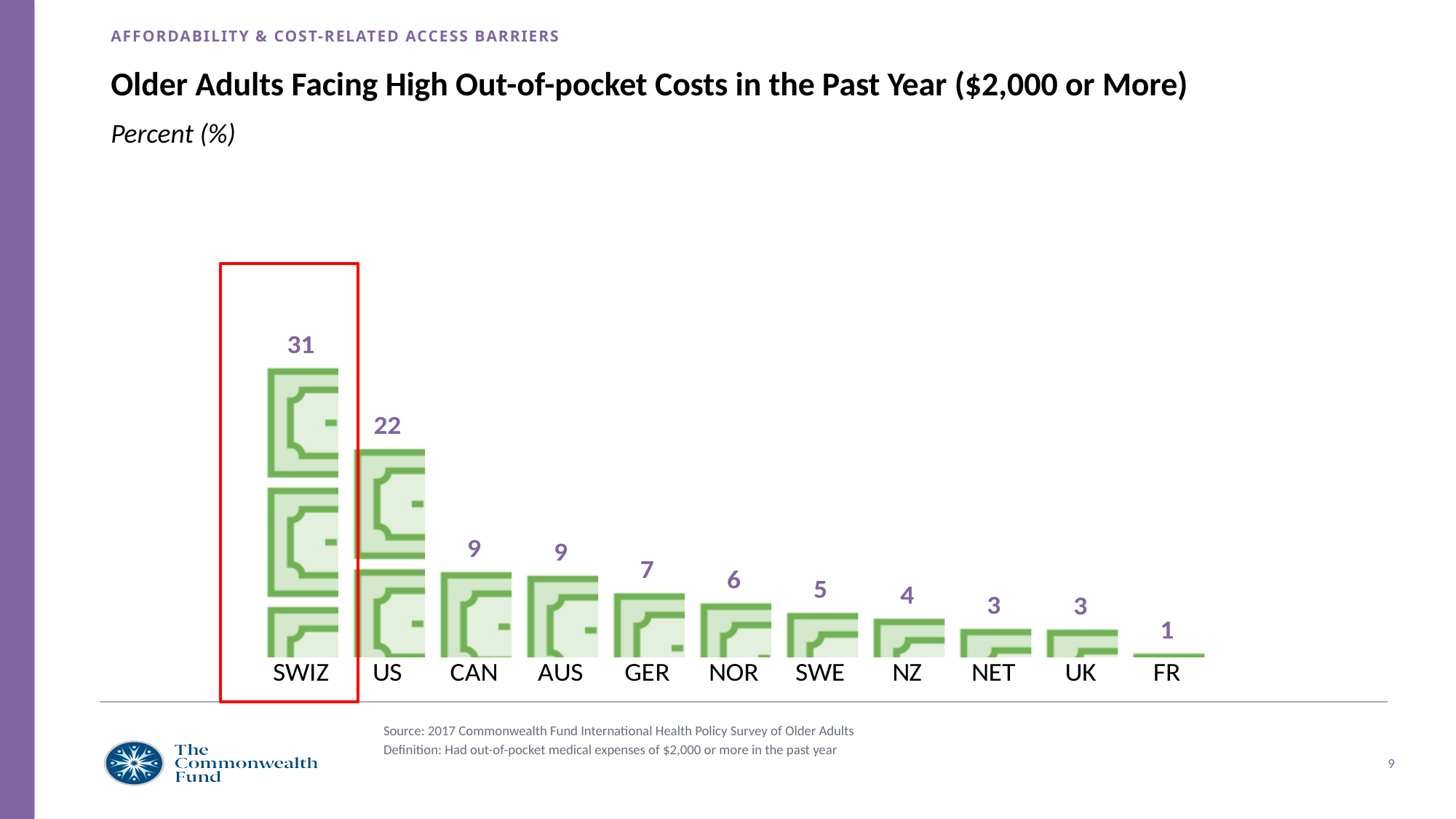
What is the difference between the values for SWIZ and US? 9 What is the value for US? 22 What is the value for FR? 1 Which country has the lowest value? FR What is the value for SWIZ? 31 What is the value for GER? 7 How many countries are shown in the chart? 11 Which has a larger value, NOR or SWE? NOR Which country is highlighted with a red box? SWIZ Do the values rise or fall from left to right along the x axis? Fall Which country has the highest value? SWIZ What kind of chart is this? Bar chart